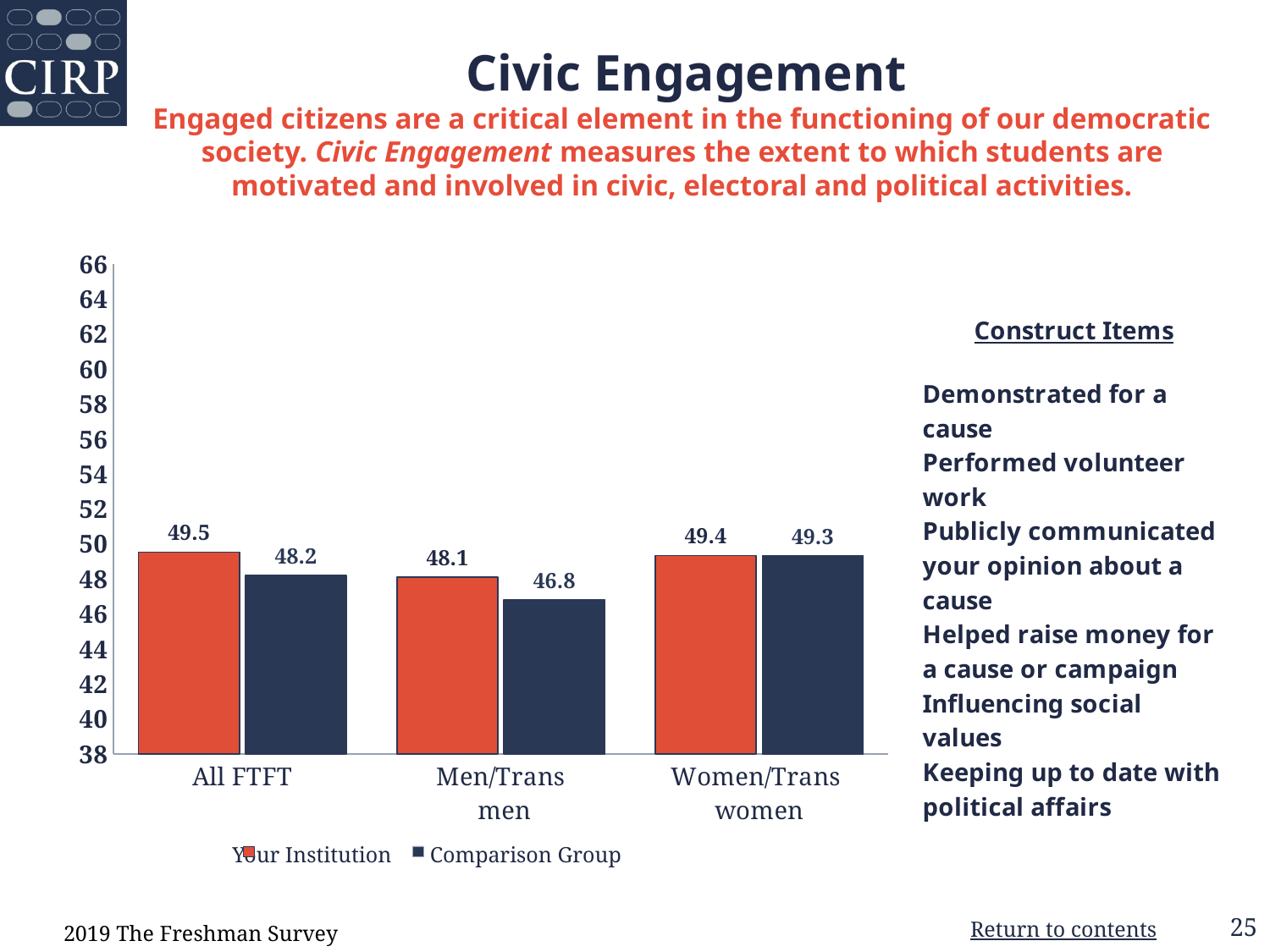
How many series does the legend list? 2 Which category has the highest Your Institution value? All FTFT What is the difference between the Your Institution and Comparison Group values for All FTFT? 1.3 What colour are the Your Institution bars? red/orange Which is larger for Men/Trans men: Your Institution or Comparison Group? Your Institution What is the difference between the Your Institution and Comparison Group values for Men/Trans men? 1.3 What is the Comparison Group value for Men/Trans men? 46.8 What is the Comparison Group value for Women/Trans women? 49.3 How many categories are shown on the x axis? 3 Which category has the lowest Comparison Group value? Men/Trans men What kind of chart is shown on the slide? bar chart What is the Your Institution value for All FTFT? 49.5